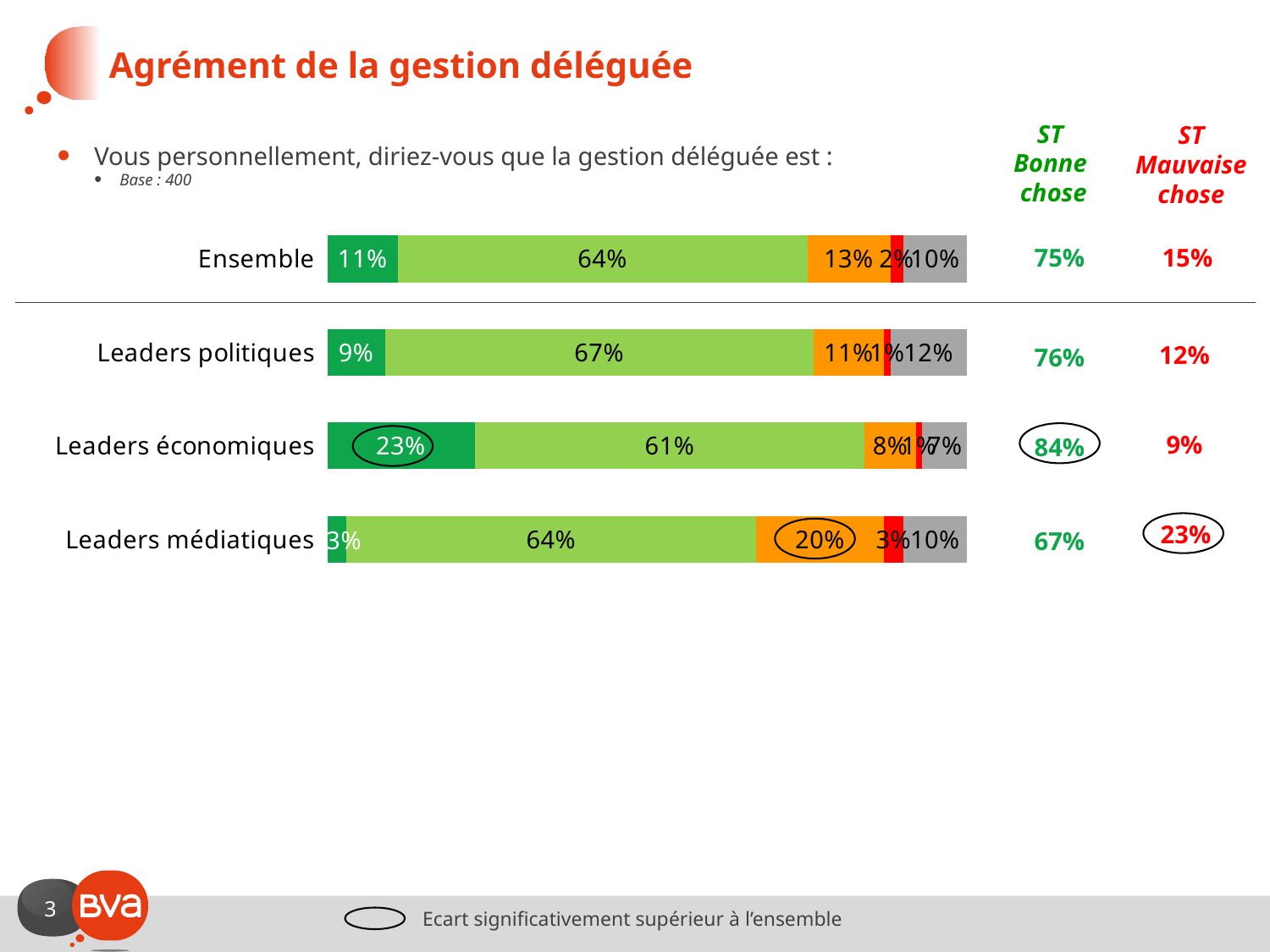
Which category has the lowest value in the dark green (first) segment? Leaders médiatiques How many categories (rows) does the bar chart show? 4 What is the value of the dark green (first) segment for Leaders économiques? 23% Which category has the highest value in the dark green (first) segment? Leaders économiques What is the value of the orange segment for Leaders médiatiques? 20% What kind of chart is shown on the slide? stacked bar chart Which is larger: the orange segment for Ensemble or the orange segment for Leaders médiatiques? Leaders médiatiques What is the value of the light green segment for Leaders politiques? 67% What is the ST Mauvaise chose value for Leaders médiatiques? 23% What is the value of the grey (last) segment for Ensemble? 10% What is the ST Bonne chose value for Leaders économiques? 84% What is the difference between the light green segment values for Leaders politiques and Leaders économiques? 6%